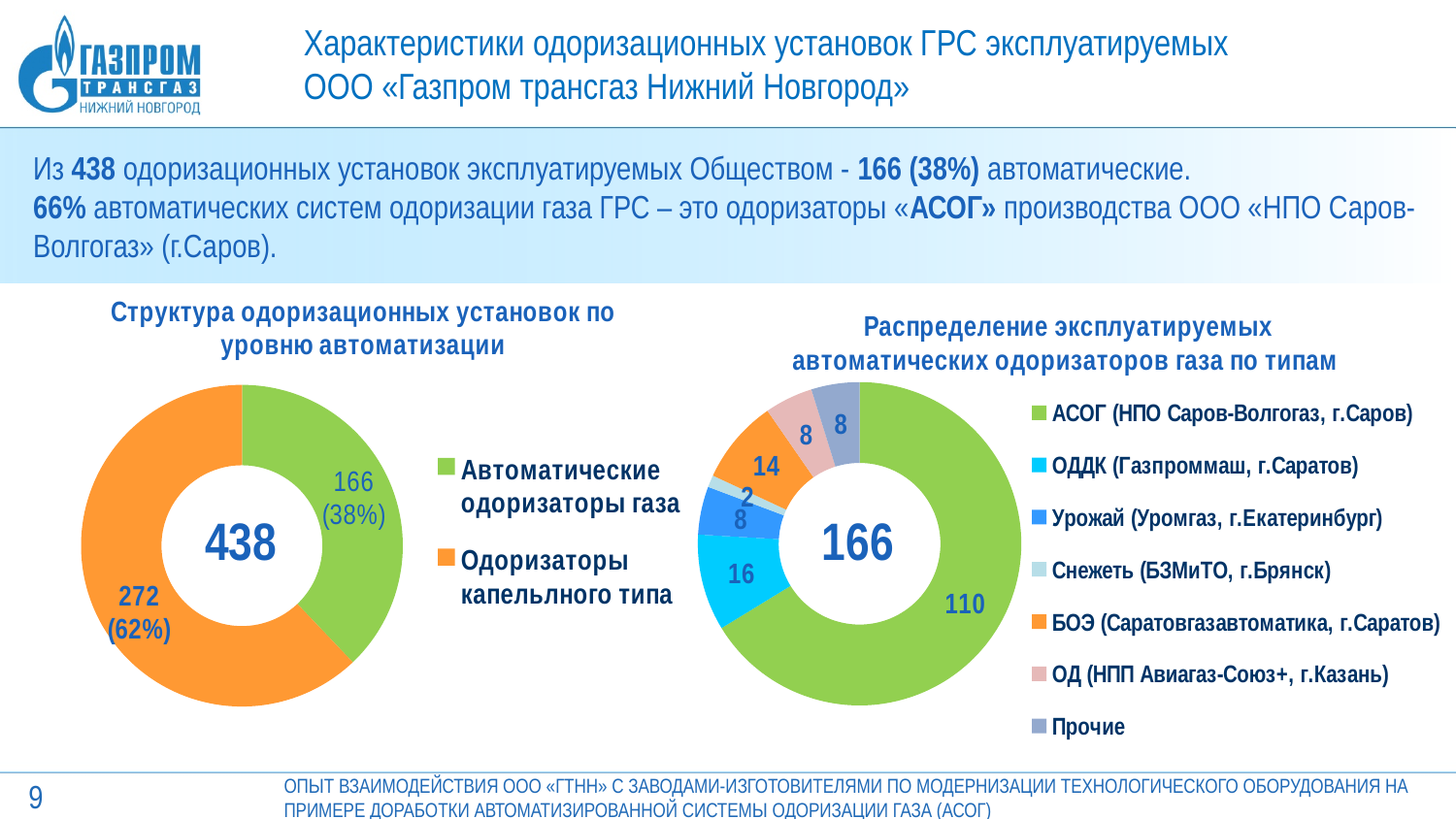
In the chart 'Структура одоризационных установок по уровню автоматизации', how many automatic gas odorizers (Автоматические одоризаторы газа) are there? 166 In the chart 'Структура одоризационных установок по уровню автоматизации', which category is larger: automatic odorizers or drip-type odorizers? Одоризаторы капельного типа How many types are listed in the legend of the chart 'Распределение эксплуатируемых автоматических одоризаторов газа по типам'? 7 In the chart 'Распределение эксплуатируемых автоматических одоризаторов газа по типам', what is the value for АСОГ (НПО Саров-Волгогаз, г.Саров)? 110 In the chart 'Структура одоризационных установок по уровню автоматизации', what percentage share do drip-type odorizers (Одоризаторы капельного типа) have? 62% In the chart 'Распределение эксплуатируемых автоматических одоризаторов газа по типам', what is the value for ОДДК (Газпроммаш, г.Саратов)? 16 In the chart 'Распределение эксплуатируемых автоматических одоризаторов газа по типам', what is the difference between the values for БОЭ (Саратовгазавтоматика, г.Саратов) and Урожай (Уромгаз, г.Екатеринбург)? 6 What type of chart is 'Структура одоризационных установок по уровню автоматизации'? Doughnut chart In the chart 'Структура одоризационных установок по уровню автоматизации', what is the difference between the number of drip-type odorizers and automatic odorizers? 106 In the chart 'Распределение эксплуатируемых автоматических одоризаторов газа по типам', which type has the highest value? АСОГ (НПО Саров-Волгогаз, г.Саров) What number is shown in the centre of the chart 'Распределение эксплуатируемых автоматических одоризаторов газа по типам'? 166 In the chart 'Распределение эксплуатируемых автоматических одоризаторов газа по типам', which type has the lowest value? Снежеть (БЗМиТО, г.Брянск)